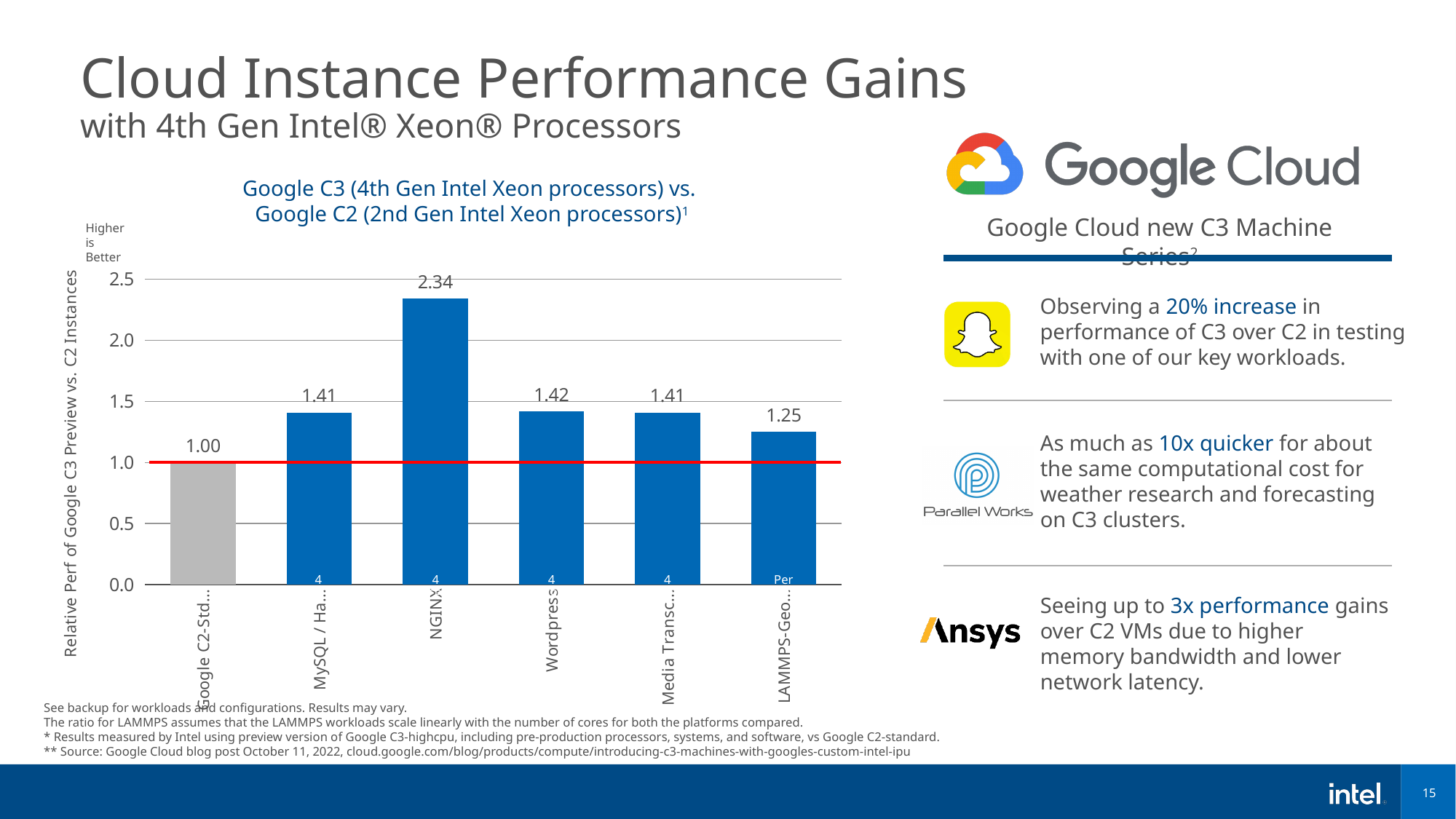
What is the value shown for Wordpress? 1.42 What kind of chart is shown on the slide? bar chart What is the difference between the Wordpress value and the LAMMPS value? 0.17 Which of the blue bars has the lowest value? LAMMPS How many bars are plotted in the chart? 6 Is the value for NGINX greater or less than 2.0? greater What is the value shown for NGINX? 2.34 What is the difference between the NGINX value and the Wordpress value? 0.92 What is the value of the grey baseline bar on the left? 1.00 Which is larger, the value for NGINX or the value for Wordpress? NGINX What is the value shown for the LAMMPS bar? 1.25 Which workload has the highest relative performance? NGINX